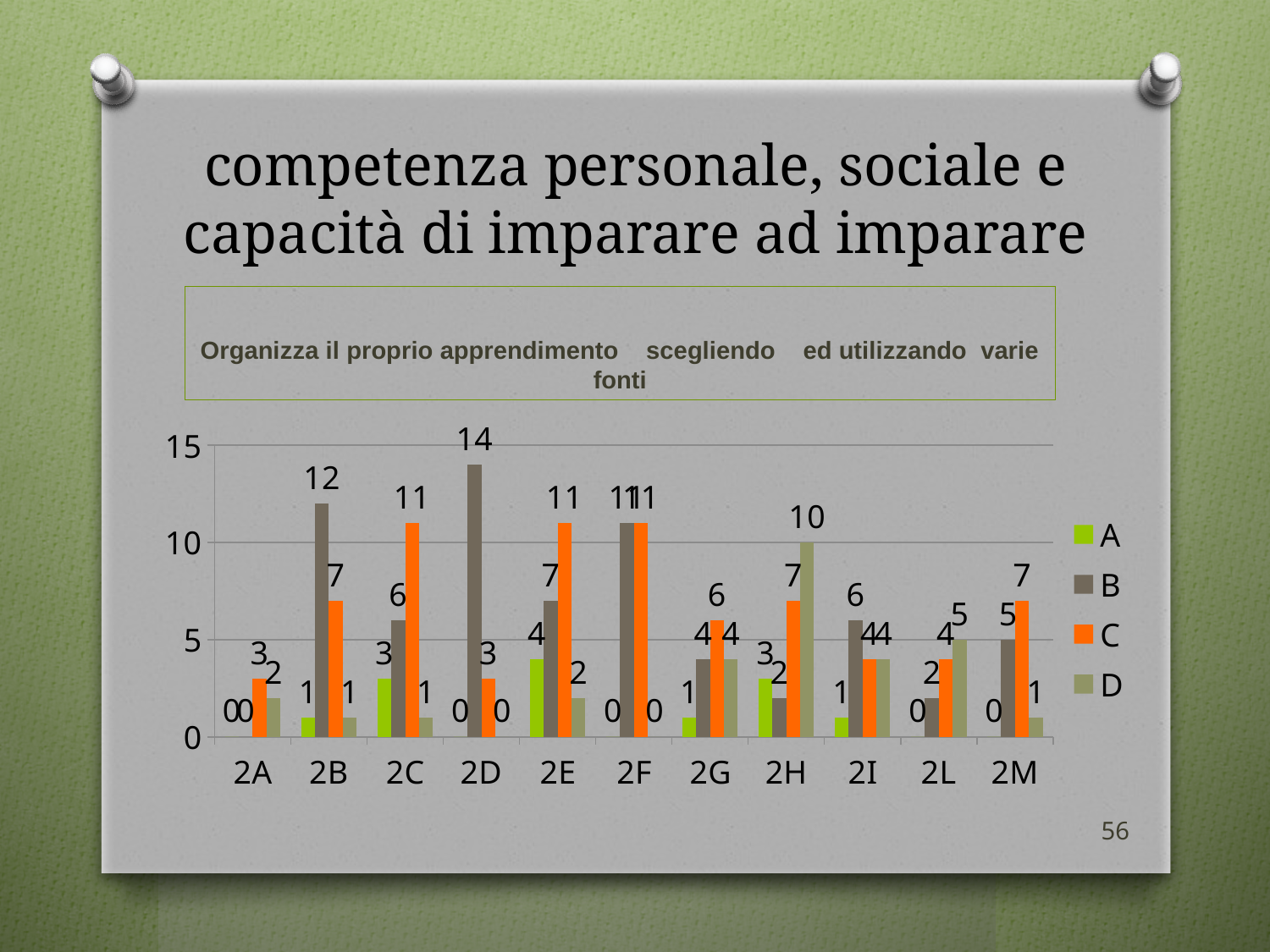
What is the value of series C for category 2C? 11 What kind of chart is shown on the slide? bar chart What colour represents series C in the legend? orange What is the value of series A for category 2E? 4 Which category has the highest value for series B? 2D Which category has the highest value for series D? 2H Which is larger for category 2I: series B or series C? B What is the value of series B for category 2D? 14 What is the difference between series B and series C for category 2B? 5 How many categories are shown on the x axis? 11 What is the value of series D for category 2H? 10 How many series does the legend list? 4